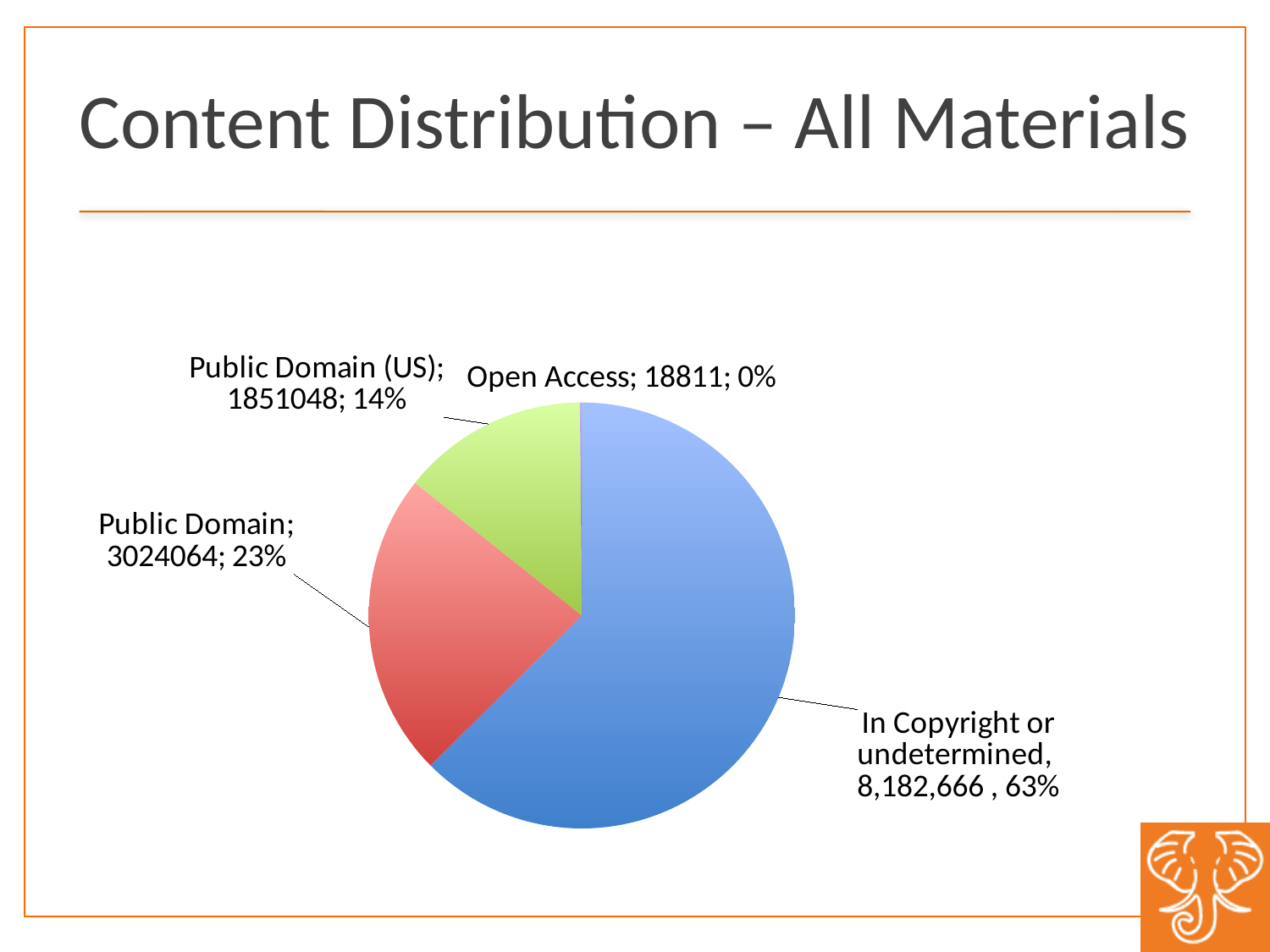
Which category has the smallest slice of the pie? Open Access How many slices does the pie chart have? 4 What is the title of the chart slide? Content Distribution – All Materials What is the value for Open Access? 18811 Which category has the largest slice of the pie? In Copyright or undetermined What share of the pie does In Copyright or undetermined represent? 63% What share of the pie does Public Domain (US) represent? 14% What is the value for Public Domain (US)? 1851048 What kind of chart is shown on the slide? Pie chart Which is larger, Public Domain or Public Domain (US)? Public Domain What is the value for Public Domain? 3024064 What is the value for In Copyright or undetermined? 8,182,666